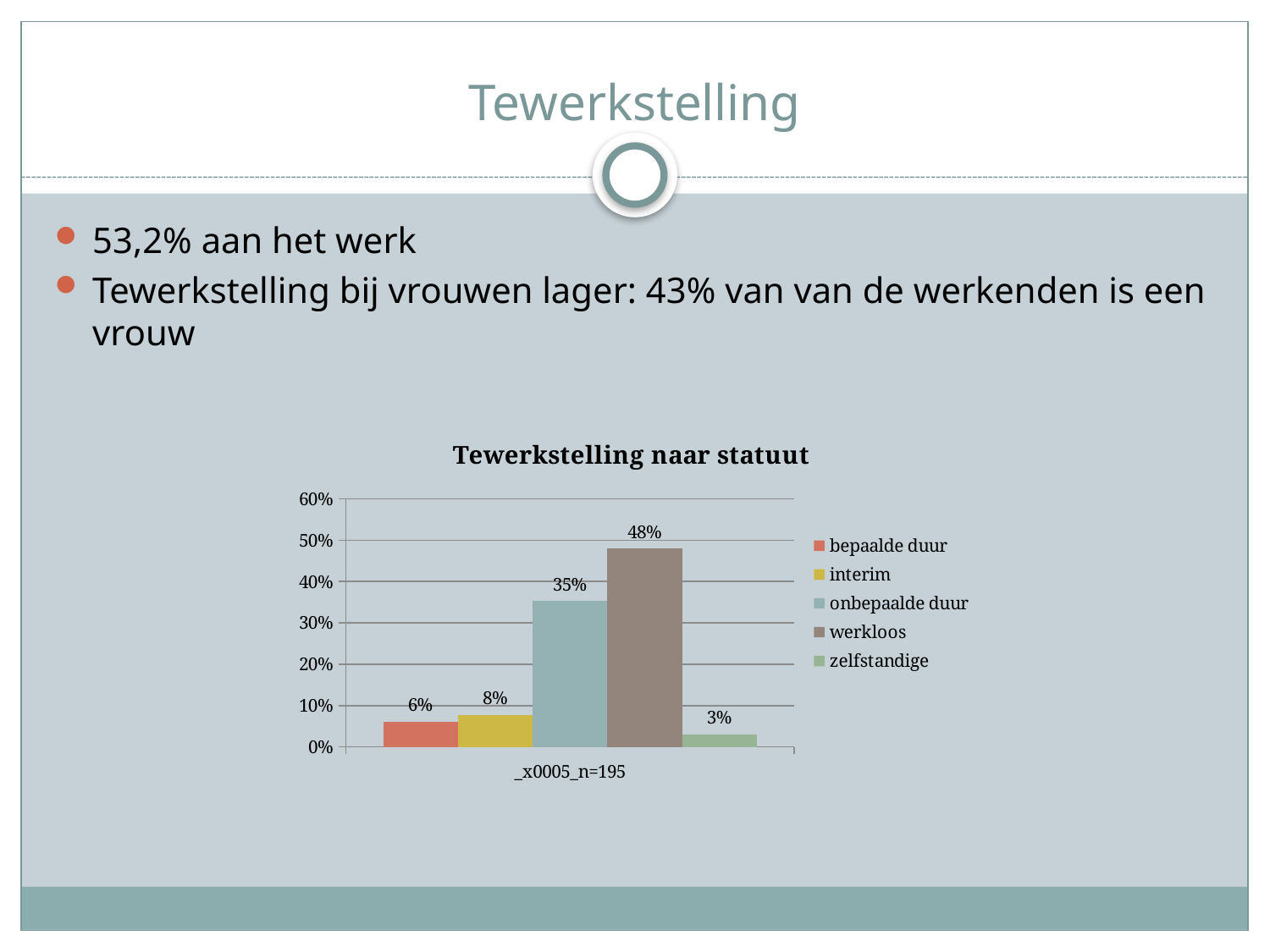
What is the x-axis label shown under the bars? _x0005_n=195 What is the value for werkloos? 48% How many series does the legend list? 5 What is the difference between the values for werkloos and onbepaalde duur? 13% What is the value for zelfstandige? 3% Which series has the highest value? werkloos What kind of chart is shown? bar chart Which is larger, the value for bepaalde duur or the value for interim? interim What is the title of the chart? Tewerkstelling naar statuut What is the value for onbepaalde duur? 35% Which series has the lowest value? zelfstandige What is the value for interim? 8%